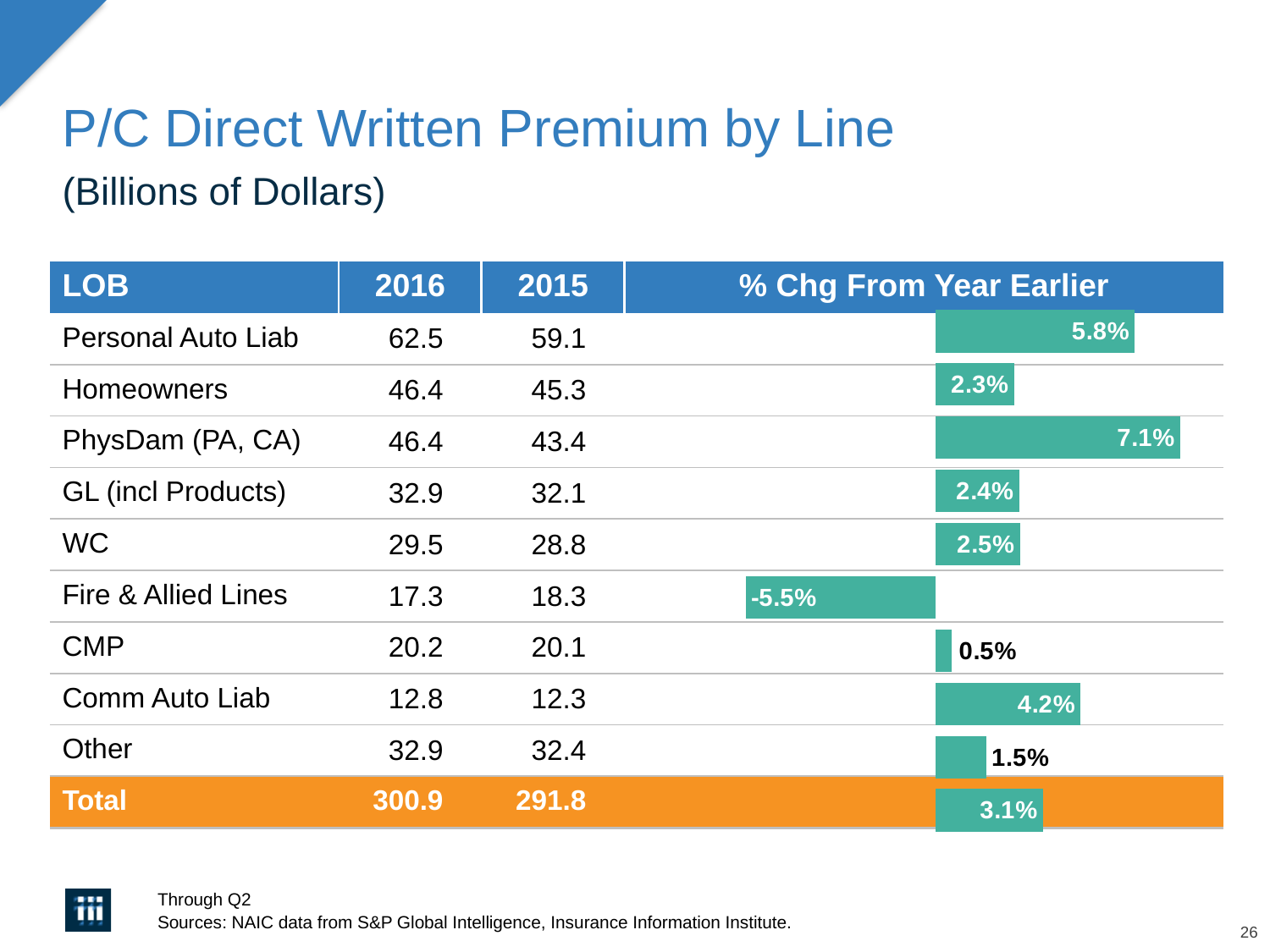
By how many billions of dollars did Personal Auto Liab direct written premium increase from 2015 to 2016? 3.4 What is the % change from a year earlier for Fire & Allied Lines? -5.5% Which line of business has the lowest % change from a year earlier? Fire & Allied Lines Which has a larger % change from a year earlier, Comm Auto Liab or Homeowners? Comm Auto Liab What is the difference in percentage points between the % change for PhysDam (PA, CA) and Homeowners? 4.8 What is the % change from a year earlier for WC? 2.5% Which line of business has the highest % change from a year earlier? PhysDam (PA, CA) How many lines of business, excluding the Total row, are shown in the chart? 9 What is the total direct written premium for 2016 in billions of dollars? 300.9 What kind of chart is used in the '% Chg From Year Earlier' column? bar chart What is the % change from a year earlier for Personal Auto Liab? 5.8% What is the title of the slide containing the chart? P/C Direct Written Premium by Line